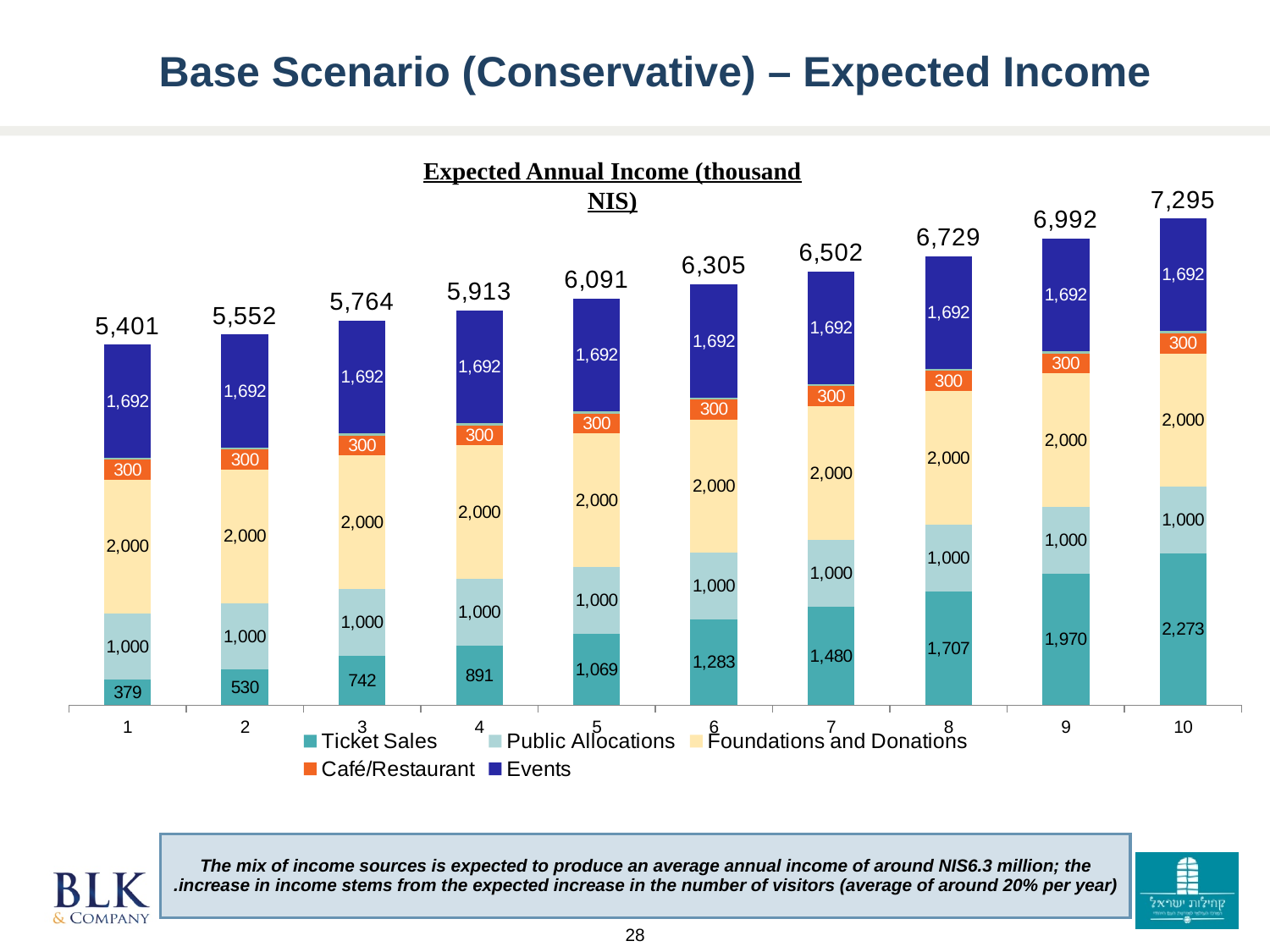
Which year has the lowest Ticket Sales value? 1 What is the difference between the total income for year 10 and the total income for year 1? 1,894 Which is larger, the Ticket Sales value for year 9 or the Foundations and Donations value for year 9? Foundations and Donations What is the Events value for year 10? 1,692 How many years (categories) are shown on the x axis? 10 What is the Ticket Sales value for year 7? 1,480 Do the total expected annual income values rise or fall from year 1 to year 10? Rise How many series does the legend list? 5 Which year has the highest total expected annual income? 10 What is the total expected annual income printed above the bar for year 1? 5,401 What type of chart is shown on the slide? Stacked bar chart What is the Café/Restaurant value for year 5? 300